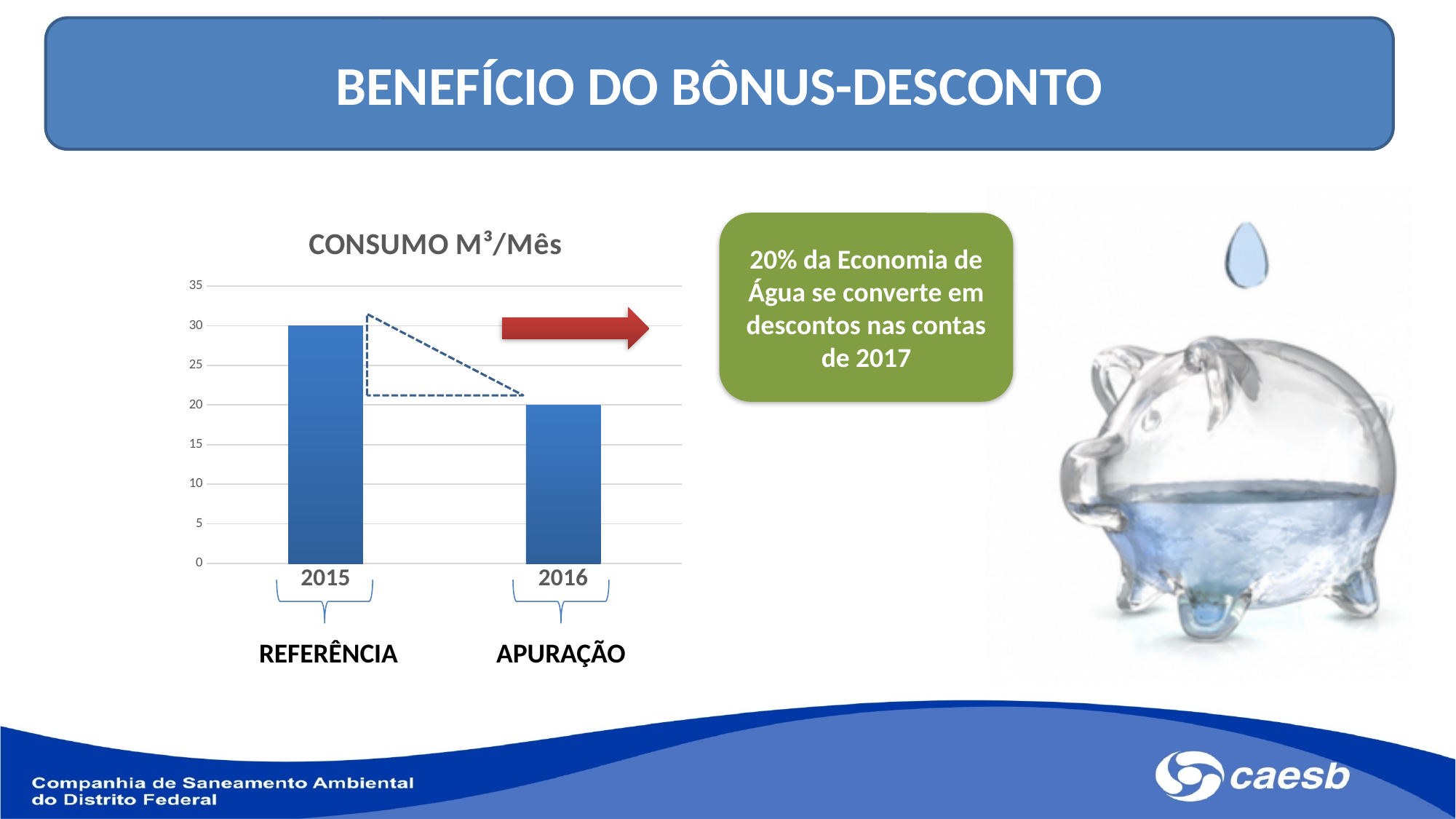
Do the values rise or fall from 2015 to 2016? fall Which year has the highest consumption in the chart? 2015 Is the value for 2016 greater or less than 25? less What kind of chart is shown on the slide? bar chart What is the value for 2015 in the CONSUMO M³/Mês chart? 30 What is the value for 2016 in the CONSUMO M³/Mês chart? 20 Is the value for 2015 greater or less than 25? greater Which year has the lowest consumption in the chart? 2016 Which is larger, the value for 2015 or the value for 2016? 2015 What is the title of the chart? CONSUMO M³/Mês What is the difference between the 2015 and 2016 values in the chart? 10 How many bars are shown in the chart? 2